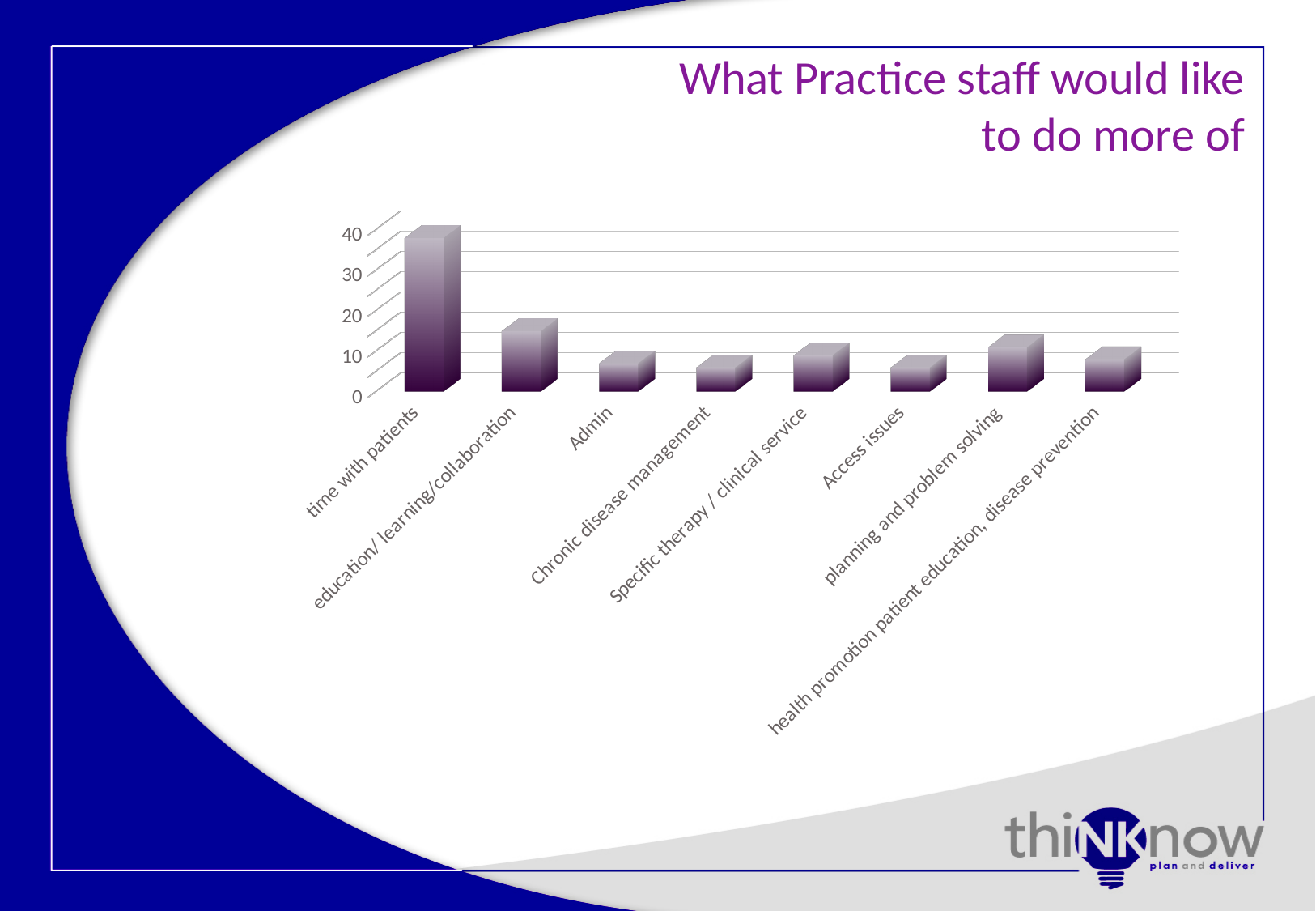
Which is larger, the value for time with patients or the value for education/ learning/collaboration? time with patients How many categories are plotted in the chart? 8 Is the value for education/ learning/collaboration greater or less than 10? greater Is the value for Chronic disease management greater or less than 10? less Is the value for time with patients greater or less than 30? greater Which is larger, the value for education/ learning/collaboration or the value for Admin? education/ learning/collaboration What kind of chart is shown on the slide? bar chart What is the title of the slide containing the chart? What Practice staff would like to do more of Which category has the highest value in the chart? time with patients Which is larger, the value for planning and problem solving or the value for Access issues? planning and problem solving